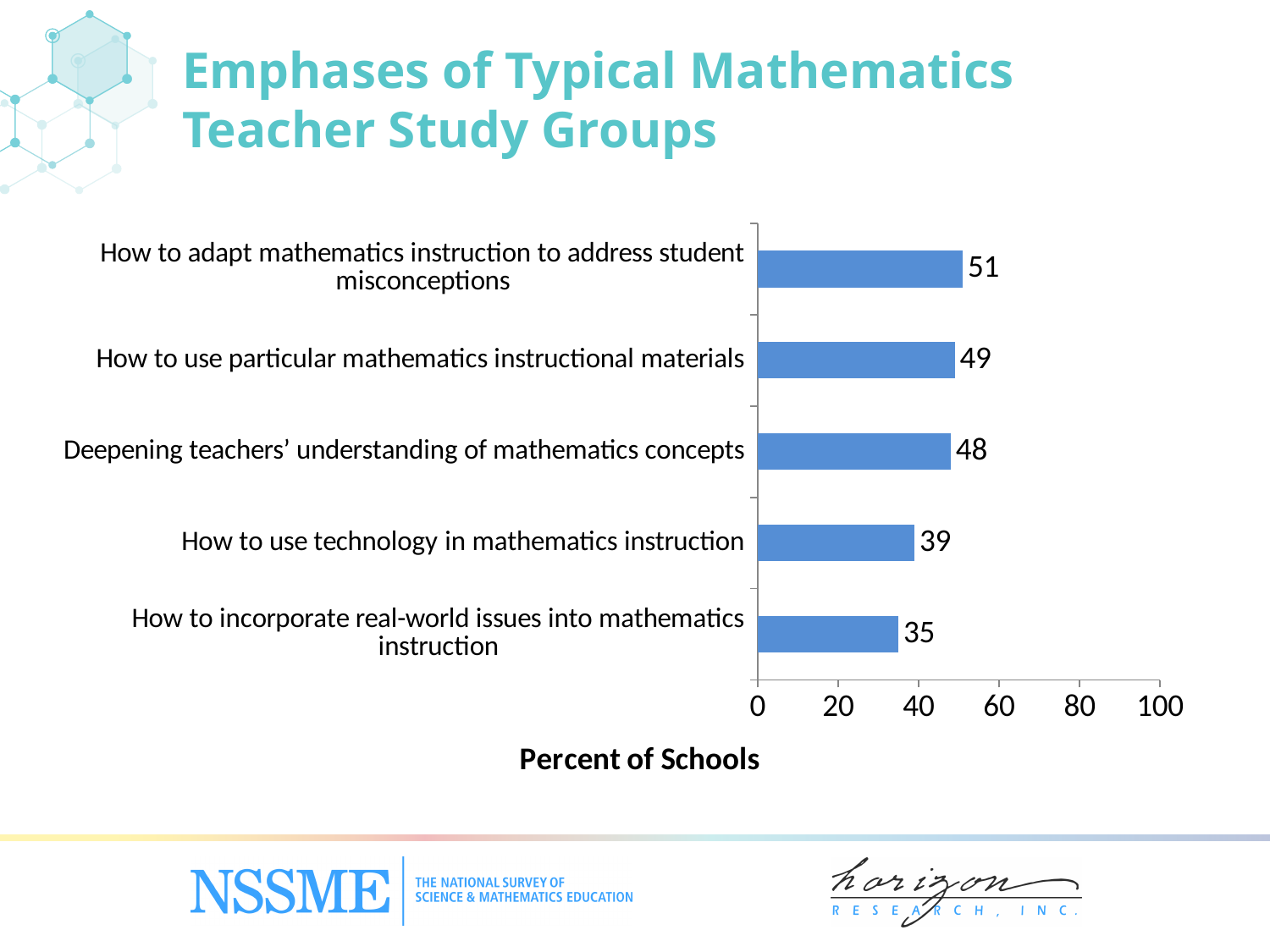
What is the value for how to incorporate real-world issues into mathematics instruction? 35 What is the difference between the highest and lowest values shown? 16 How many categories are shown in the chart? 5 What is the label of the horizontal axis? Percent of Schools Which is larger: the value for deepening teachers' understanding of mathematics concepts or the value for how to incorporate real-world issues into mathematics instruction? Deepening teachers' understanding of mathematics concepts What kind of chart is shown on the slide? Bar chart What is the difference between the values for how to use particular mathematics instructional materials and how to use technology in mathematics instruction? 10 Which category has the lowest percent of schools? How to incorporate real-world issues into mathematics instruction What is the value for how to use technology in mathematics instruction? 39 Is the value for how to use technology in mathematics instruction greater or less than 40? less Which category has the highest percent of schools? How to adapt mathematics instruction to address student misconceptions What percent of schools reported an emphasis on how to adapt mathematics instruction to address student misconceptions? 51